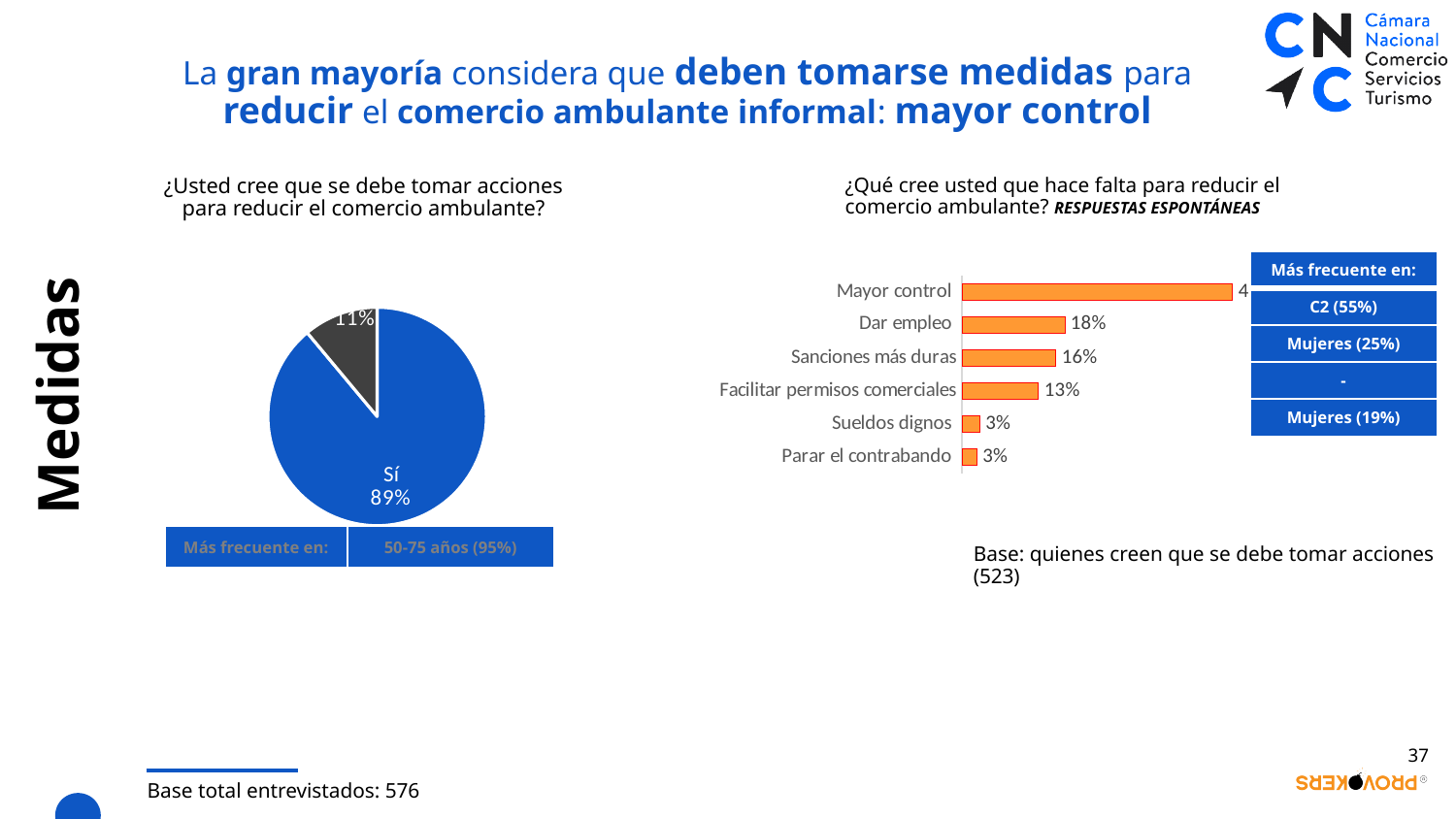
In the bar chart on the right, what is the value for "Facilitar permisos comerciales"? 13% In the pie chart on the left, what percentage does the smaller (dark) slice represent? 11% What kind of chart is the chart on the right of the slide? Bar chart In the bar chart on the right, what is the difference between "Dar empleo" and "Facilitar permisos comerciales"? 5% In the bar chart on the right, which is larger, "Sanciones más duras" or "Sueldos dignos"? Sanciones más duras In the bar chart on the right, which category has the highest value? Mayor control In the bar chart on the right, what is the value for "Dar empleo"? 18% What kind of chart is the chart on the left of the slide? Pie chart In the bar chart on the right, what is the value for "Sanciones más duras"? 16% In the bar chart on the right, how many categories are shown? 6 In the bar chart on the right, what is the value for "Sueldos dignos"? 3% In the pie chart on the left, what share of respondents answered "Sí"? 89%